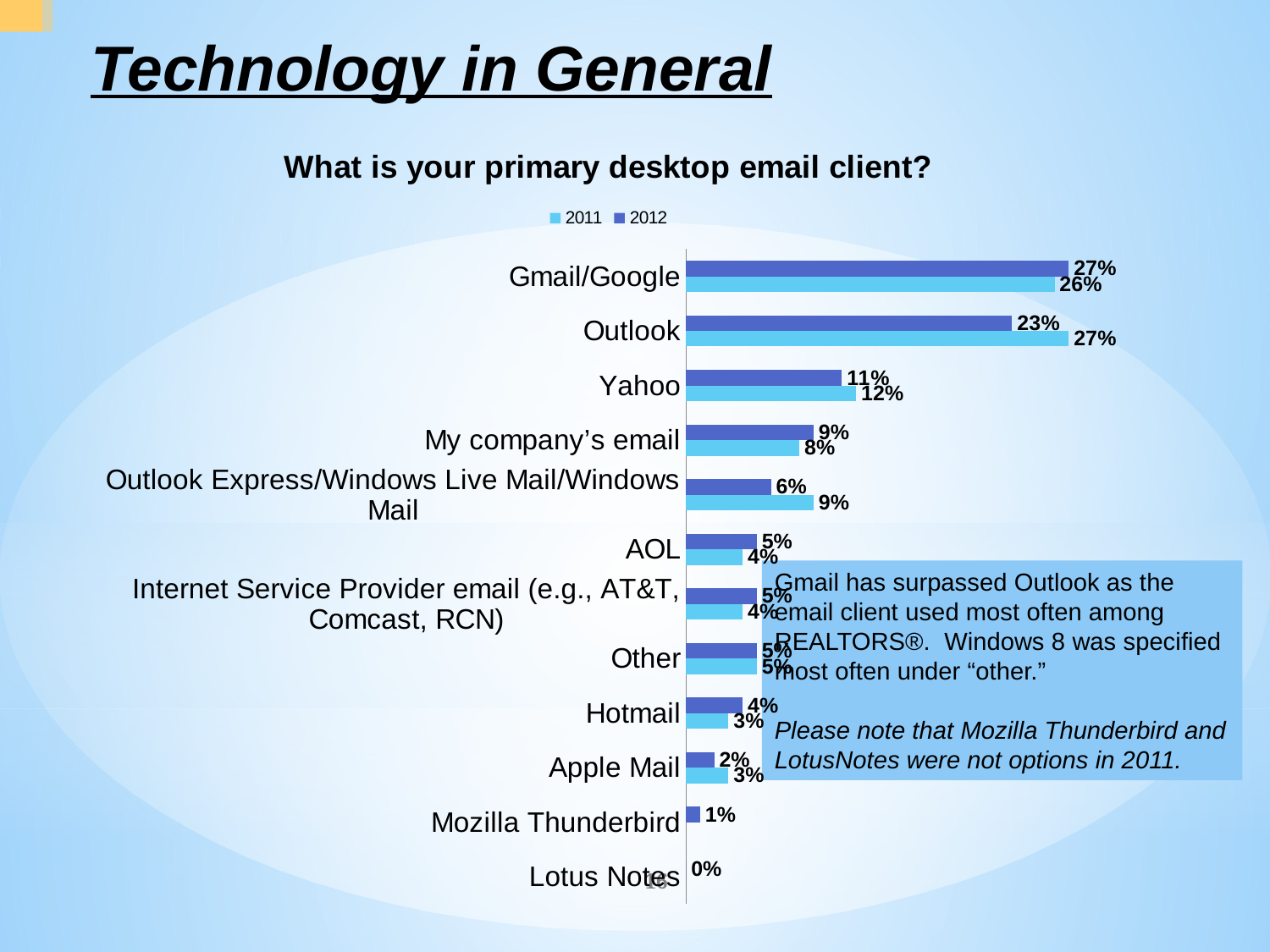
What is the 2011 value for Outlook? 27% What is the difference between the 2011 and 2012 values for Outlook? 4% What type of chart is shown on the slide? bar chart What is the 2012 value for Yahoo? 11% What is the 2011 value for Outlook Express/Windows Live Mail/Windows Mail? 9% What is the title of the chart? What is your primary desktop email client? Which is larger for Hotmail, the 2011 value or the 2012 value? 2012 How many email client categories are shown in the chart? 12 What is the 2012 value for Gmail/Google? 27% How many series does the legend list? 2 Which email client has the lowest 2012 value? Lotus Notes Which email client has the highest 2012 value? Gmail/Google